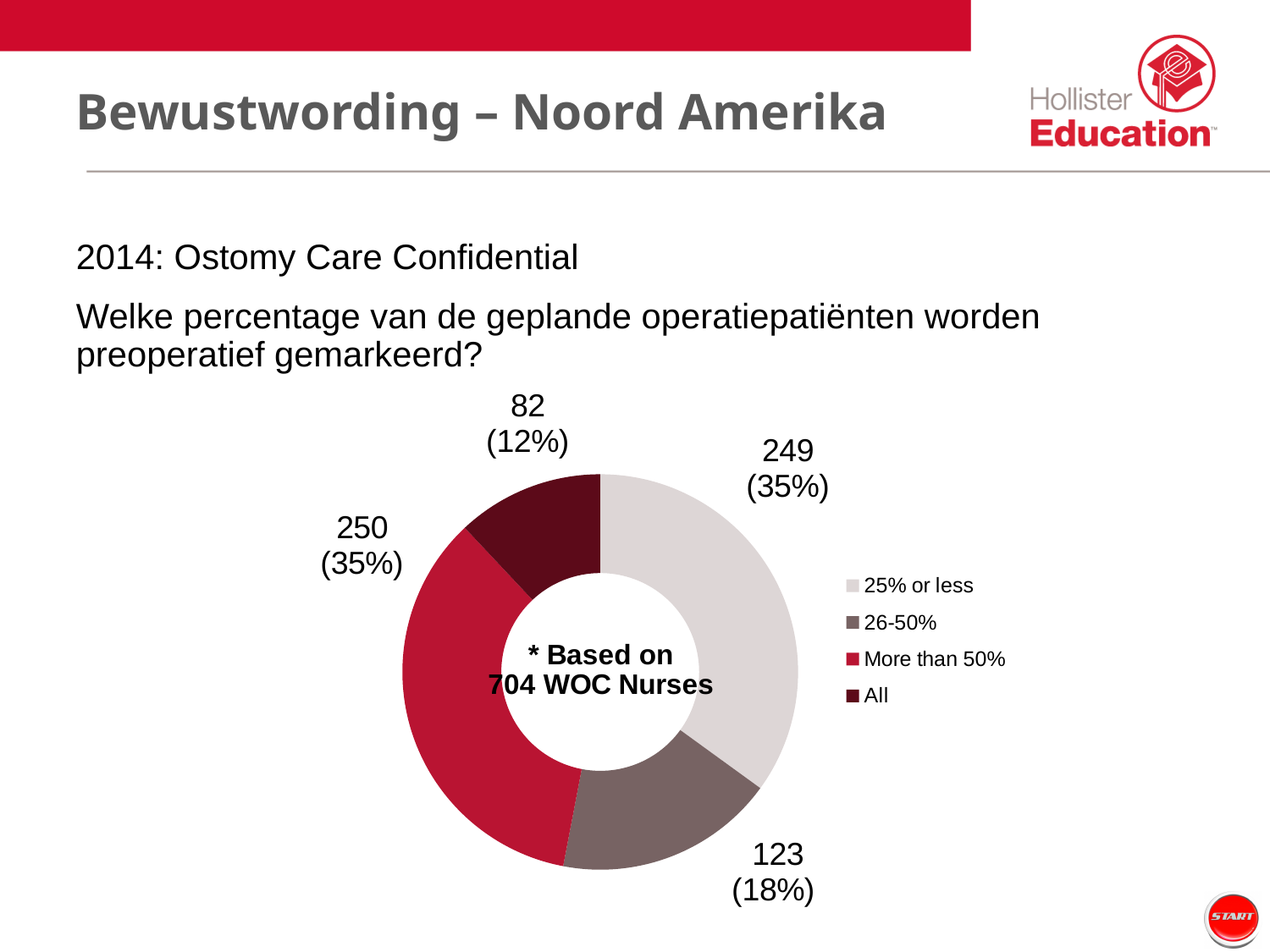
What is the difference between the counts for '25% or less' and '26-50%'? 126 Which is larger, the count for '26-50%' or the count for 'All'? 26-50% What share of the doughnut does the 'All' slice represent? 12% What kind of chart is shown on the slide? Doughnut (pie) chart What share of the doughnut does the '26-50%' slice represent? 18% What is the count for the '26-50%' slice? 123 How many entries does the legend list? 4 What is the count for the '25% or less' slice? 249 How many slices does the doughnut chart have? 4 Which category has the smallest slice? All What is the count for the 'More than 50%' slice? 250 What is the count for the 'All' slice? 82